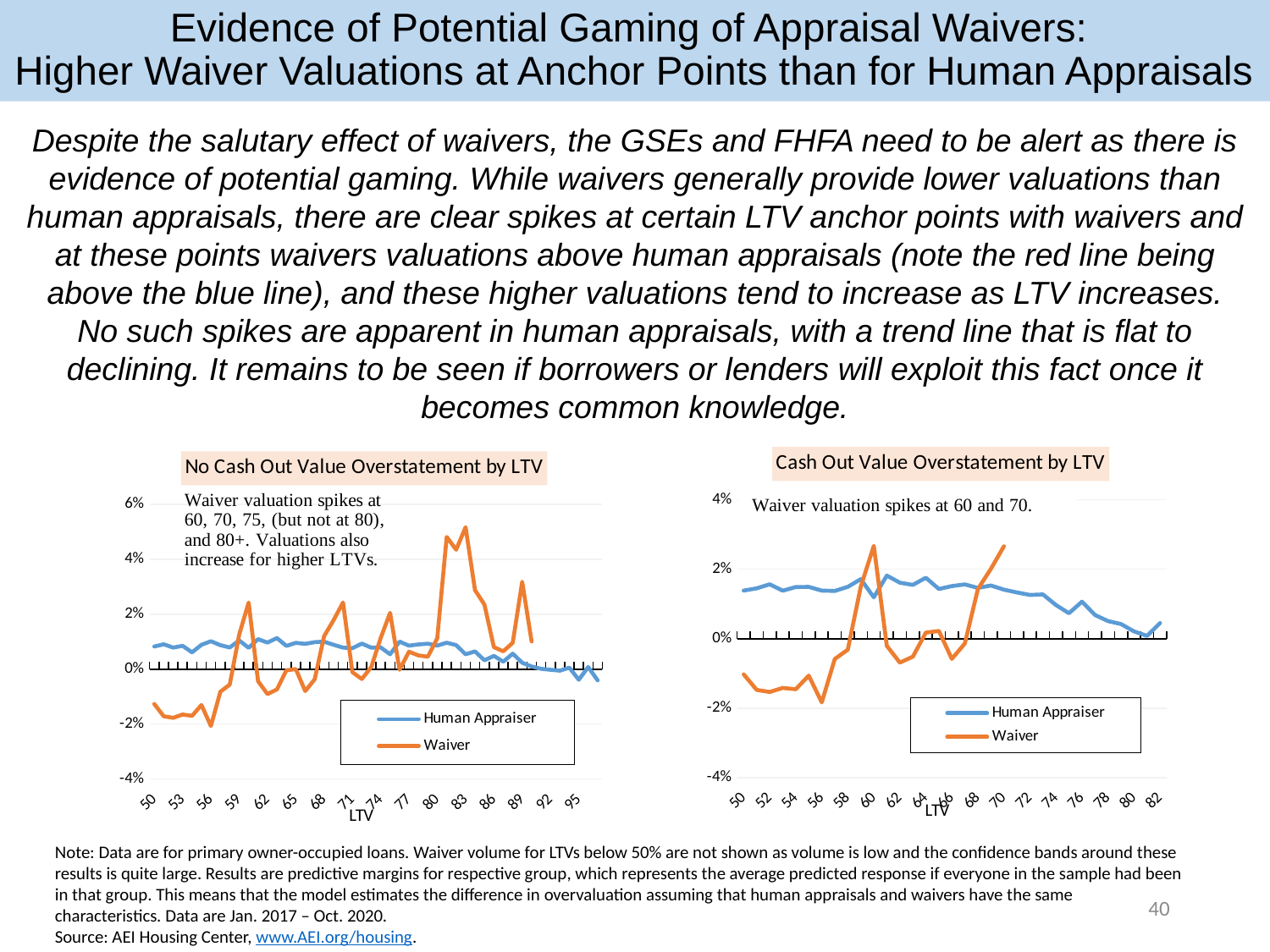
In the "Cash Out Value Overstatement by LTV" chart, at LTV 70, which series has the larger value, Human Appraiser or Waiver? Waiver In the "Cash Out Value Overstatement by LTV" chart, is the Waiver value at LTV 50 greater or less than 0%? less What is the title of the chart on the right side of the slide? Cash Out Value Overstatement by LTV In the "No Cash Out Value Overstatement by LTV" chart, which two series are listed in the legend? Human Appraiser and Waiver In the "Cash Out Value Overstatement by LTV" chart, does the Human Appraiser series generally rise or fall as LTV increases from 60 to 80? Fall In the "Cash Out Value Overstatement by LTV" chart, is the Human Appraiser value at LTV 50 greater or less than 0%? greater In the "Cash Out Value Overstatement by LTV" chart, is the Waiver value at LTV 70 greater or less than 2%? greater How many series does the legend of the "Cash Out Value Overstatement by LTV" chart list? 2 In the "No Cash Out Value Overstatement by LTV" chart, at LTV 50, which series has the larger value, Human Appraiser or Waiver? Human Appraiser What kind of chart is the "No Cash Out Value Overstatement by LTV" chart? Line chart